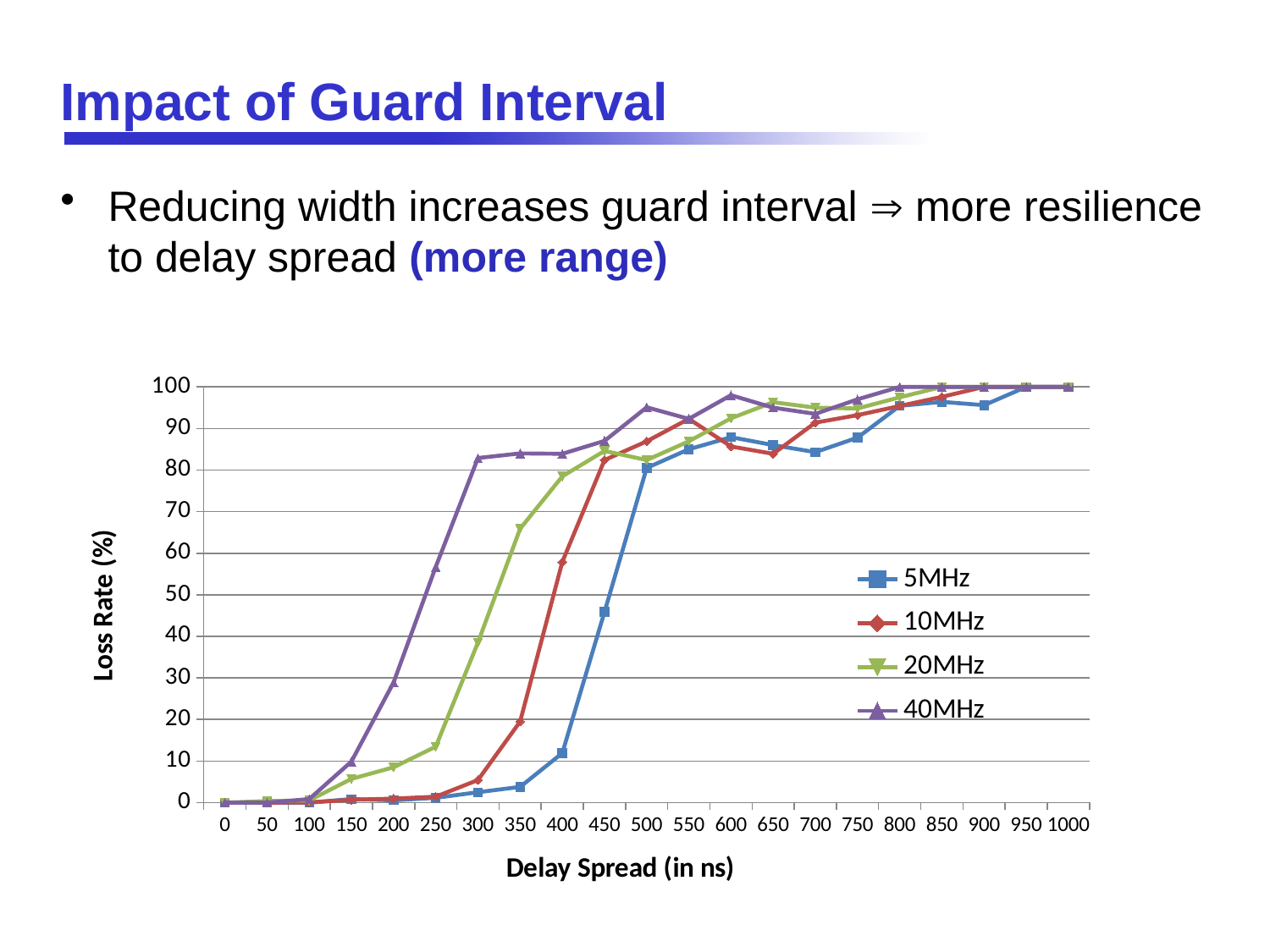
Is the loss rate for 10MHz at a delay spread of 300 ns greater or less than 10? less Does the loss rate for 5MHz generally rise or fall as delay spread increases? rise What is the title of the y axis? Loss Rate (%) What kind of chart is shown on the slide? line chart How many delay spread values are marked along the x axis? 21 Is the loss rate for 40MHz at a delay spread of 300 ns greater or less than 70? greater At a delay spread of 250 ns, which has the higher loss rate, 40MHz or 5MHz? 40MHz Is the loss rate for 5MHz at a delay spread of 400 ns greater or less than 20? less At a delay spread of 400 ns, which has the higher loss rate, 10MHz or 20MHz? 20MHz What is the title of the x axis? Delay Spread (in ns) How many series does the legend list? 4